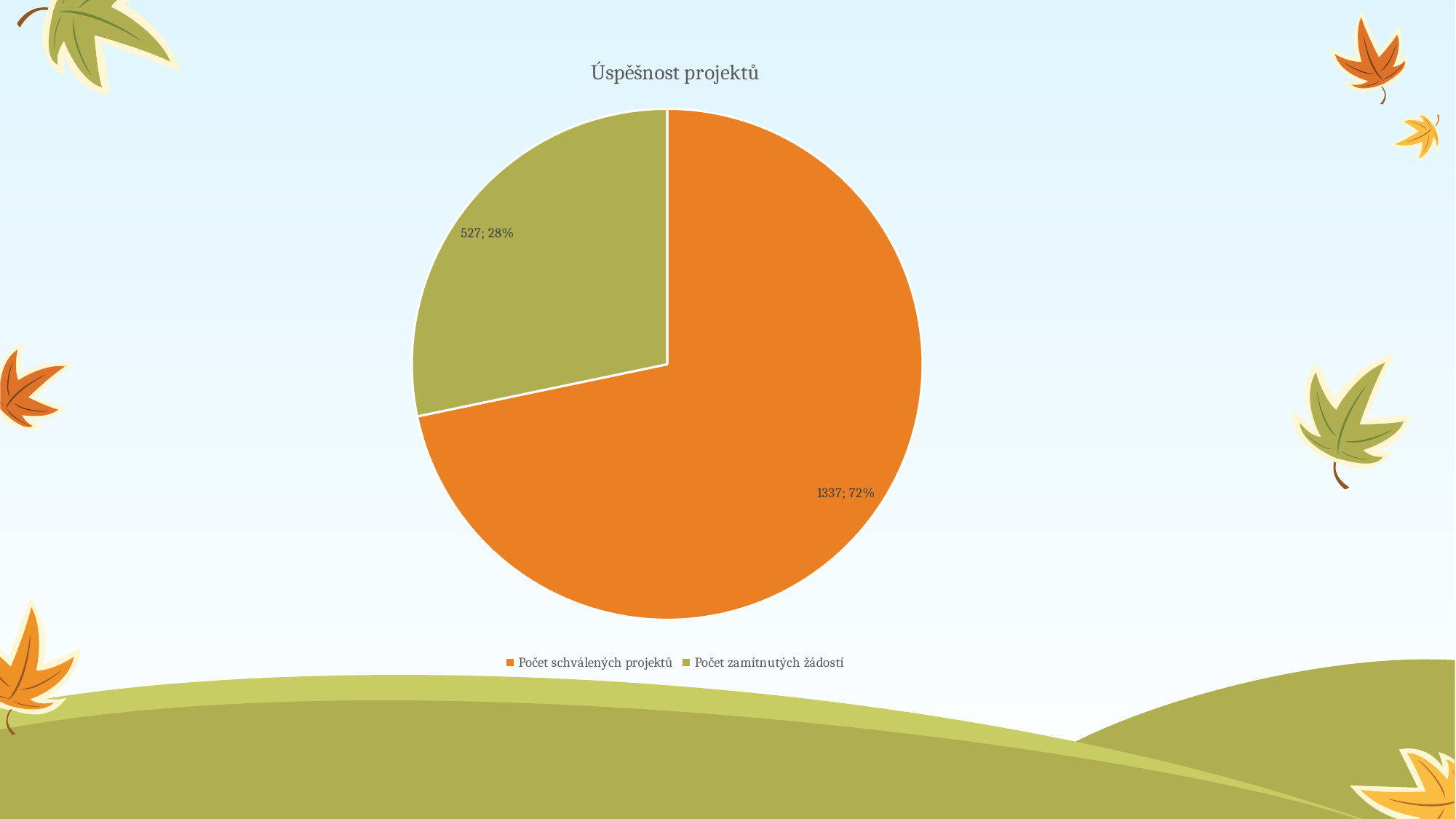
What colour is the slice for Počet zamítnutých žádostí? Green What share of the pie does Počet schválených projektů represent? 72% How many slices does the pie chart have? 2 What is the value for Počet zamítnutých žádostí? 527 What kind of chart is shown on the slide? Pie chart What is the value for Počet schválených projektů? 1337 What share of the pie does Počet zamítnutých žádostí represent? 28% What is the difference between the values for Počet schválených projektů and Počet zamítnutých žádostí? 810 Which category has the largest slice? Počet schválených projektů What is the title of the chart? Úspěšnost projektů Which is larger, Počet schválených projektů or Počet zamítnutých žádostí? Počet schválených projektů Which category has the smallest slice? Počet zamítnutých žádostí